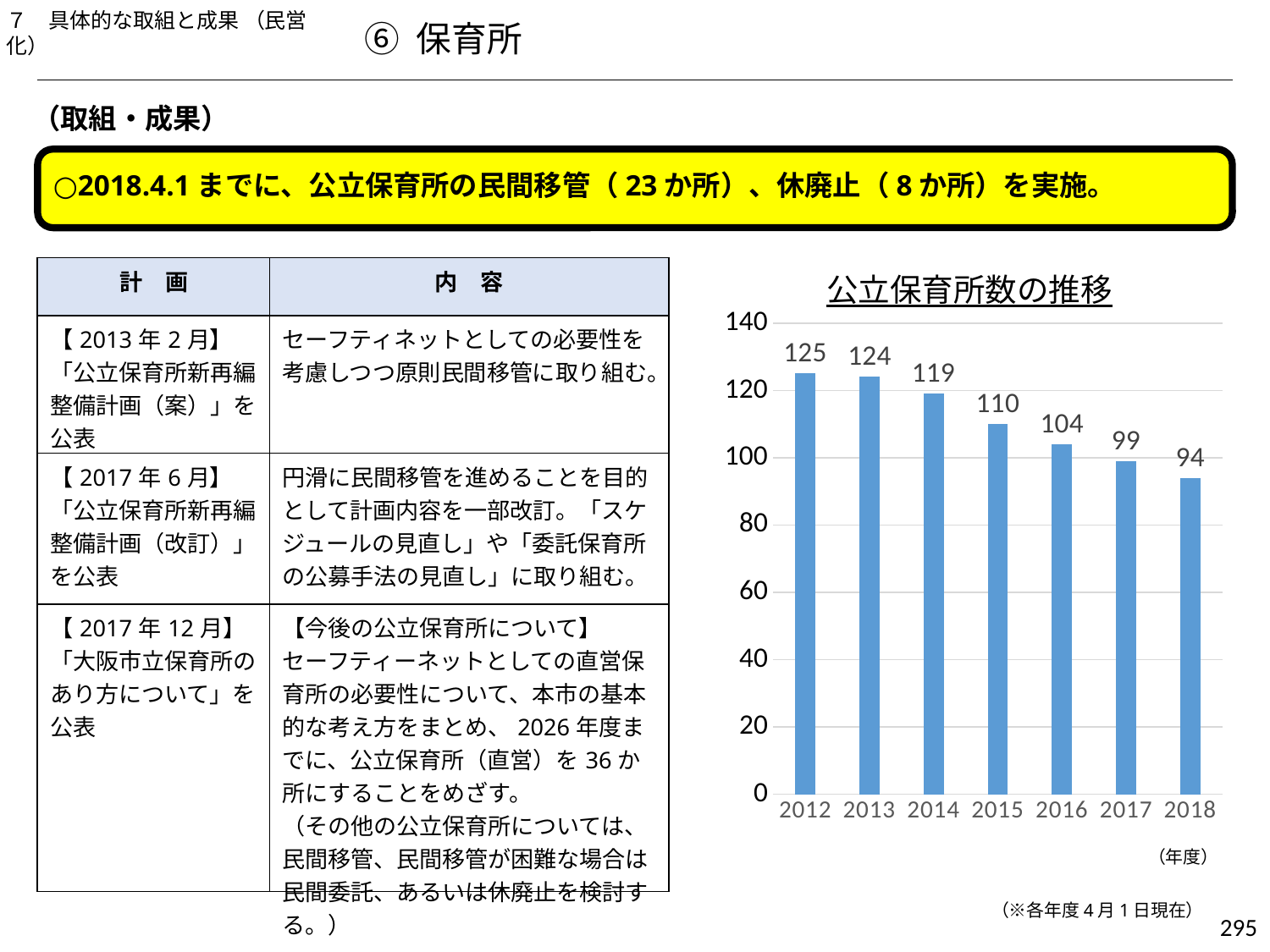
Which year has the highest value in the chart? 2012 What is the value for 2012 in the chart? 125 Is the value for 2017 greater or less than 100? less What kind of chart is shown on the slide? bar chart Do the values rise or fall from 2012 to 2018? fall How many years are shown on the x axis of the chart? 7 What is the difference between the values for 2012 and 2018? 31 Which year has the lowest value in the chart? 2018 What is the difference between the values for 2014 and 2015? 9 What is the value for 2018 in the chart? 94 What is the value for 2015 in the chart? 110 Which is larger, the value for 2016 or the value for 2017? 2016